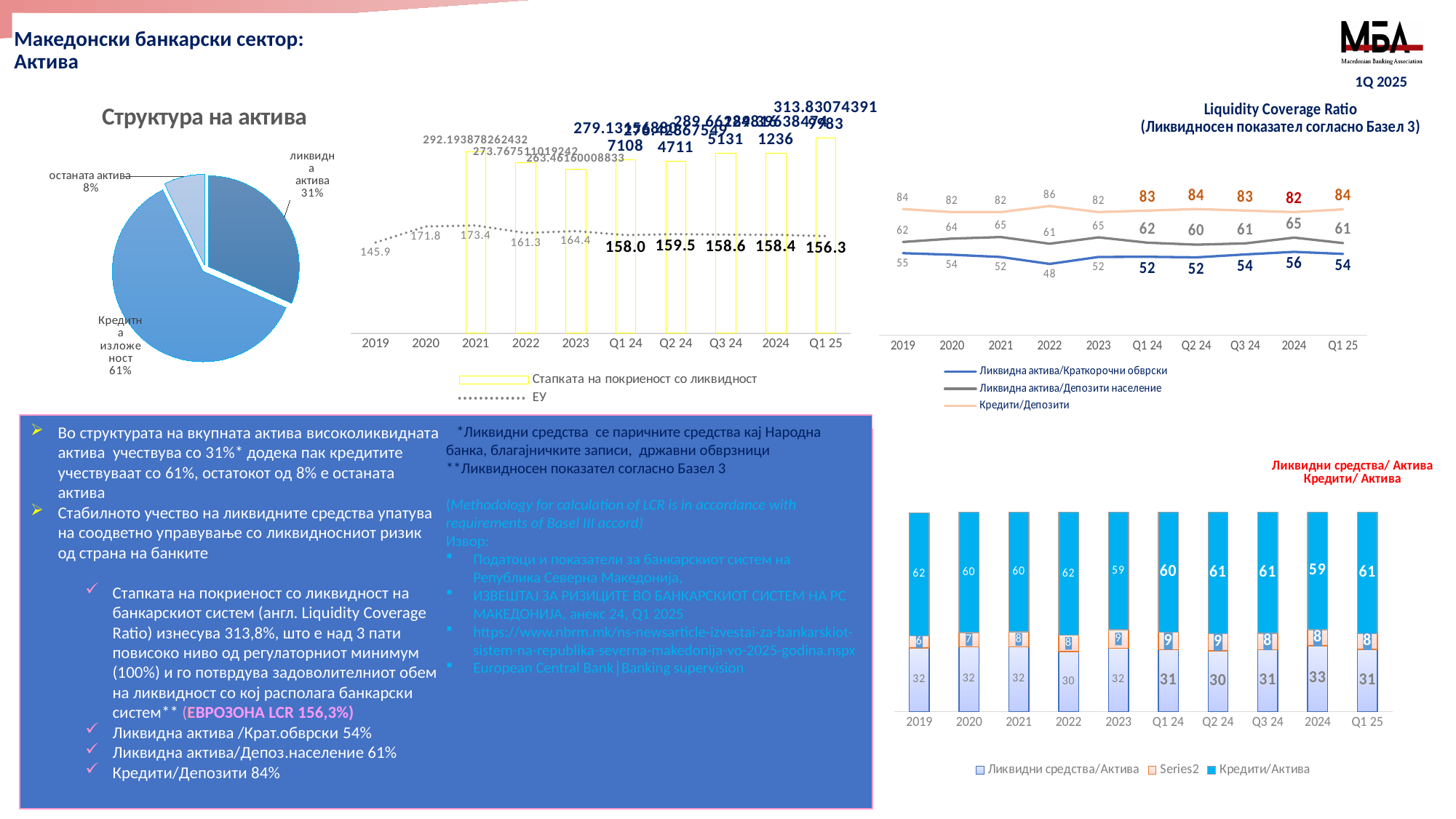
In the middle chart with the 'ЕУ' dotted line, which category has the highest ЕУ value? 2021 In the middle chart with the 'ЕУ' dotted line, what is the ЕУ value for 2019? 145.9 In the stacked bar chart at the bottom right, what is the value of 'Кредити/Актива' for 2023? 59 In the 'Liquidity Coverage Ratio' line chart, what is the value of 'Кредити/Депозити' for 2022? 86 In the pie chart 'Структура на актива', what share is 'Кредитна изложеност'? 61% In the pie chart 'Структура на актива', how many slices are there? 3 In the stacked bar chart at the bottom right, what is the total of the 2024 bar? 100 In the middle chart with the 'ЕУ' dotted line, what is the ЕУ value for Q1 25? 156.3 In the pie chart 'Структура на актива', what share is 'останата актива'? 8% In the 'Liquidity Coverage Ratio' line chart, what is the value of 'Ликвидна актива/Краткорочни обврски' for 2022? 48 In the 'Liquidity Coverage Ratio' line chart, how many series does the legend list? 3 In the 'Liquidity Coverage Ratio' line chart, what is the difference between 'Ликвидна актива/Депозити население' and 'Ликвидна актива/Краткорочни обврски' for Q1 25? 7